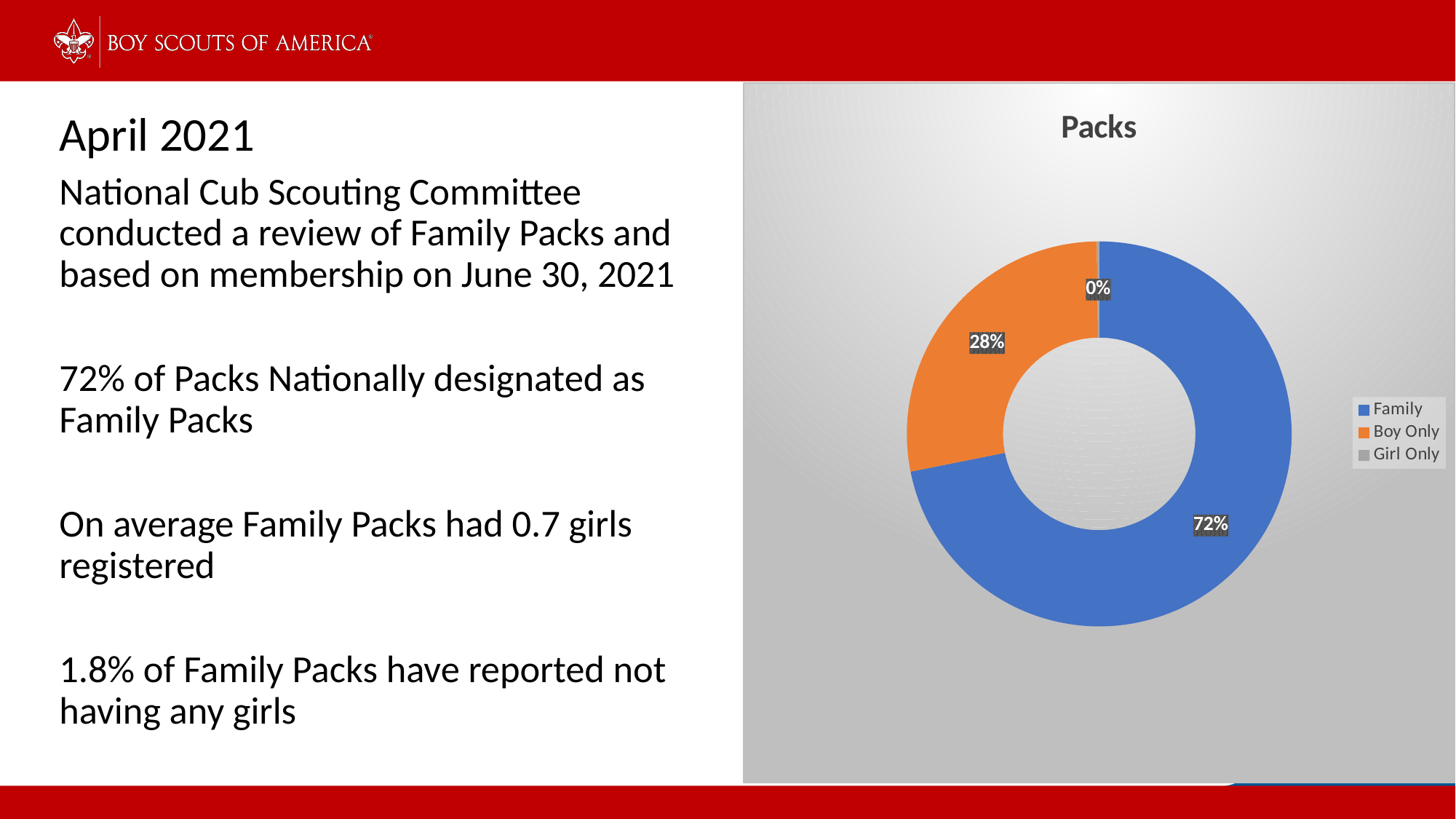
How many categories does the chart show? 3 Which category has the smallest share of packs? Girl Only What is the difference in percentage points between Family and Boy Only packs? 44 What percentage of packs are Boy Only? 28% What kind of chart is shown on the slide? Pie chart (doughnut) Which category has the largest share of packs? Family Which is larger, the share of Family packs or the share of Boy Only packs? Family What percentage of packs are Family packs? 72% What is the title of the chart? Packs Which colour represents Boy Only packs in the chart? Orange How many entries does the legend list? 3 What percentage of packs are Girl Only? 0%